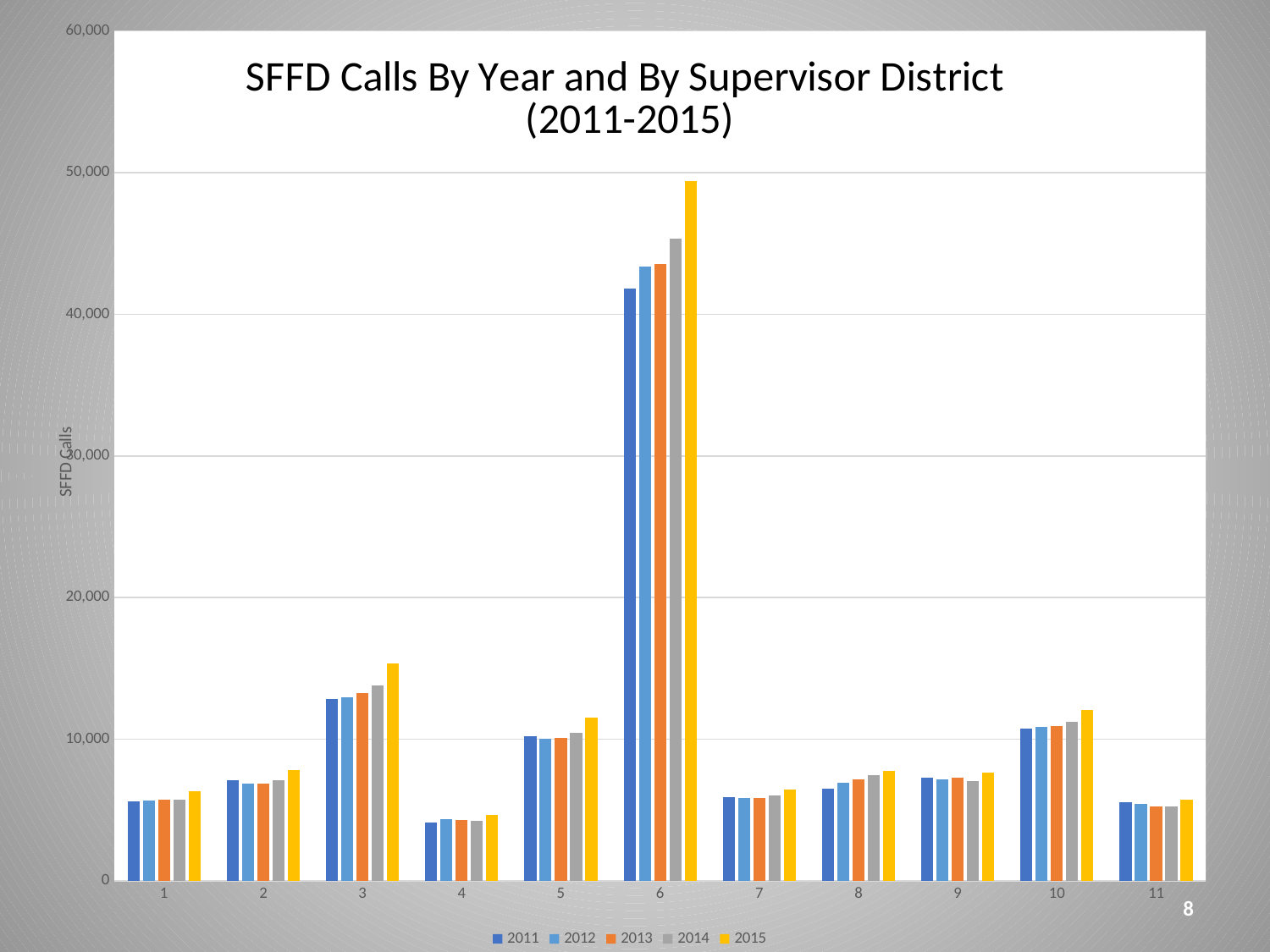
What is the title of the chart? SFFD Calls By Year and By Supervisor District (2011-2015) In district 6, which year has the highest number of calls? 2015 Which supervisor district has the highest number of SFFD calls? 6 How many supervisor districts are shown on the x axis? 11 Is the value for district 6 in 2015 greater or less than 40,000? greater Which supervisor district has the lowest number of SFFD calls? 4 Is the value for district 4 in 2011 greater or less than 10,000? less What kind of chart is shown on the slide? bar chart Is the value for district 3 in 2015 greater or less than 10,000? greater How many series does the legend list? 5 In district 6, do the values rise or fall from 2011 to 2015? rise Which is larger: the 2015 value for district 3 or the 2015 value for district 5? district 3